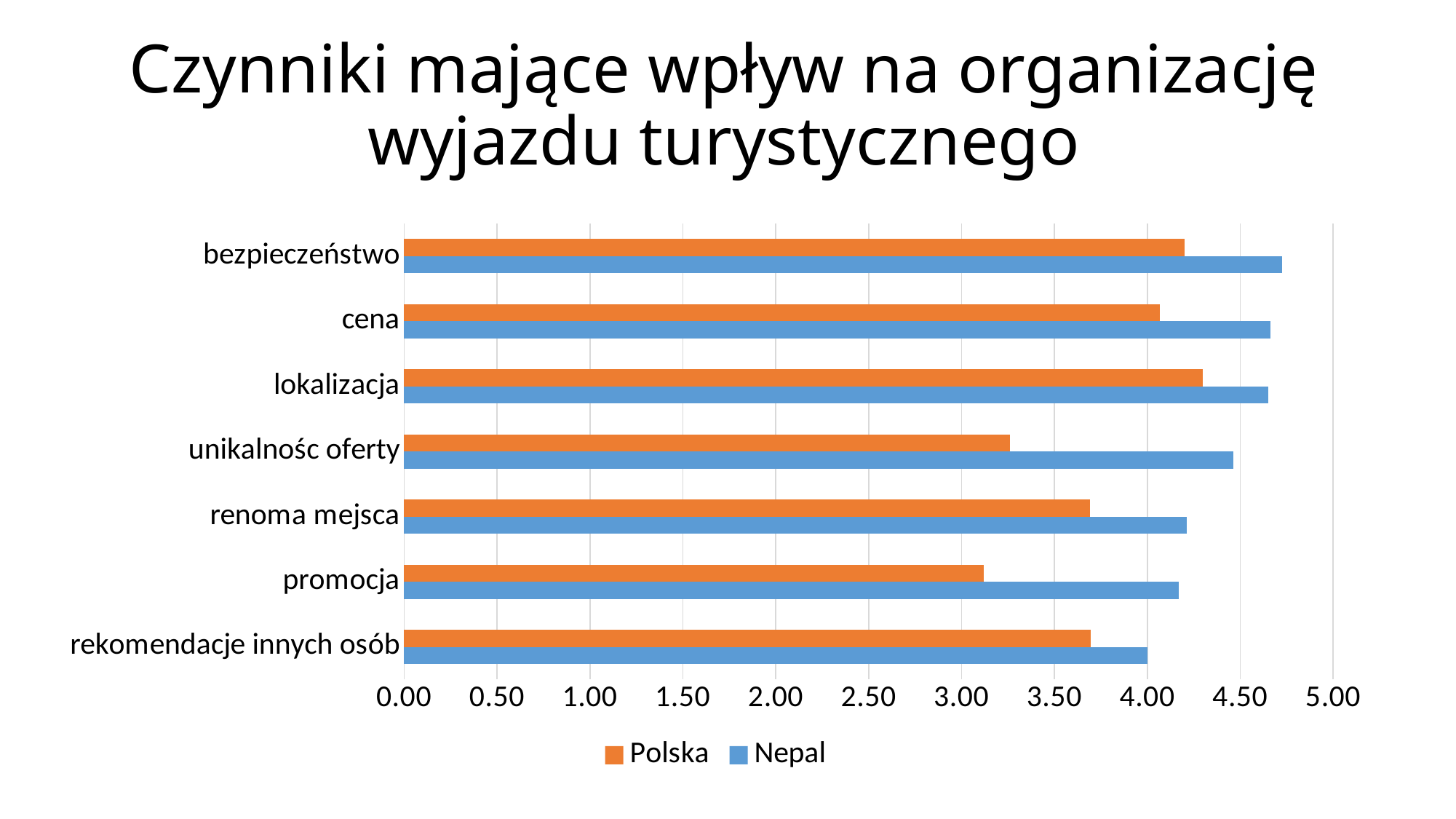
How many series does the legend list? 2 For unikalność oferty, which series has the larger value, Polska or Nepal? Nepal Is the Nepal value for unikalność oferty greater or less than 4.00? greater Is the Polska value for bezpieczeństwo greater or less than 4.00? greater Which series does the orange colour represent in the legend? Polska For which category is the Nepal value lowest? rekomendacje innych osób Is the Polska value for renoma mejsca greater or less than 3.50? greater For promocja, which series has the larger value, Polska or Nepal? Nepal What kind of chart is shown on the slide? bar chart For which category is the Polska value lowest? promocja How many categories are shown on the chart? 7